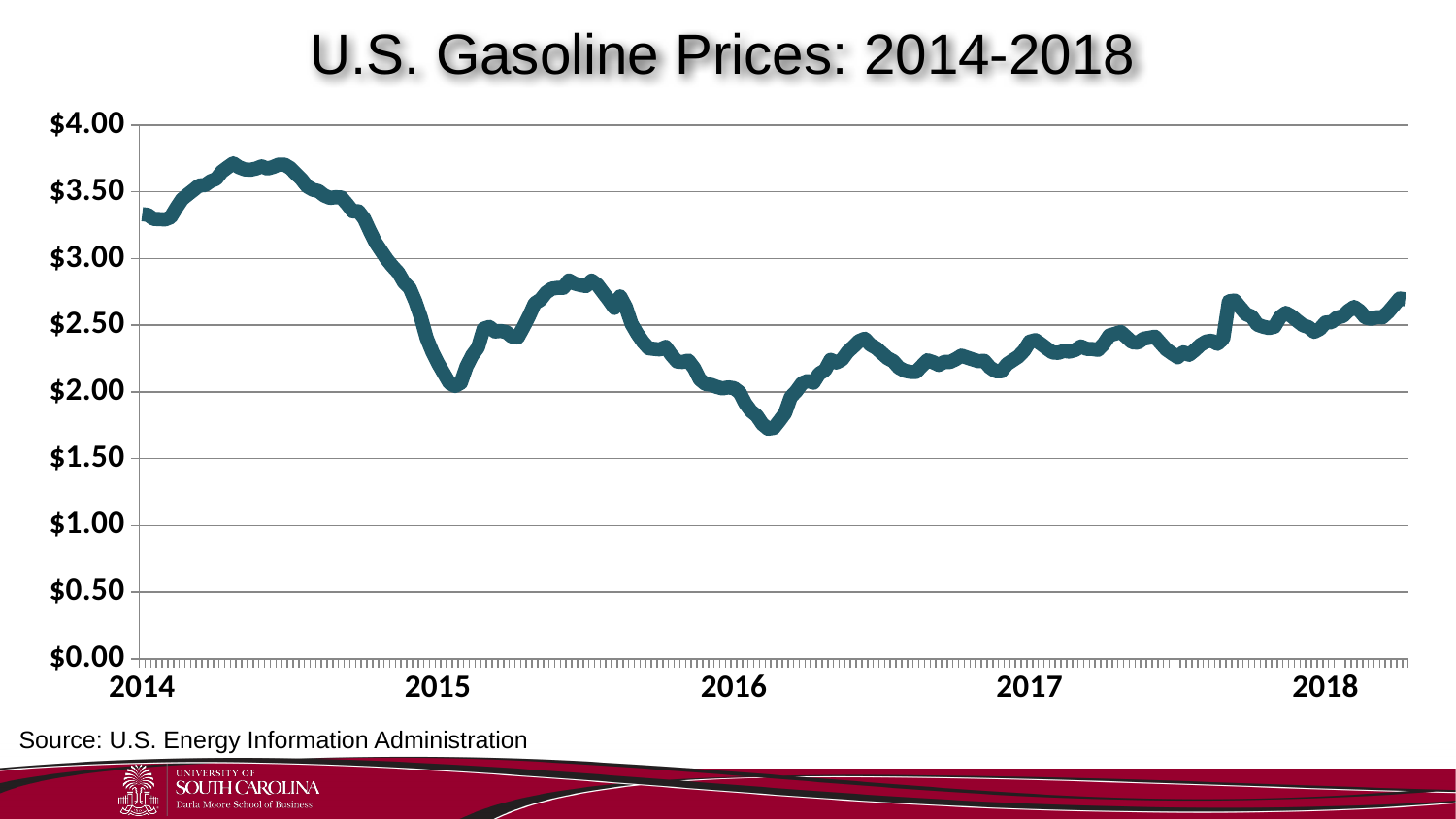
Is the gasoline price at the start of 2018 greater or less than $2.00? greater In which year labeled on the x axis does the line reach its lowest point? 2016 Is the gasoline price at the start of 2017 greater or less than $2.50? less Is the lowest gasoline price reached in early 2016 greater or less than $2.00? less What kind of chart is shown on the slide? line chart Overall, do gasoline prices rise or fall from the start of 2014 to the end of the series in 2018? fall In which year labeled on the x axis does the line reach its highest point? 2014 How many year labels are shown on the x axis? 5 Is the gasoline price at the start of 2014 higher or lower than at the start of 2016? higher What is the title of the chart? U.S. Gasoline Prices: 2014-2018